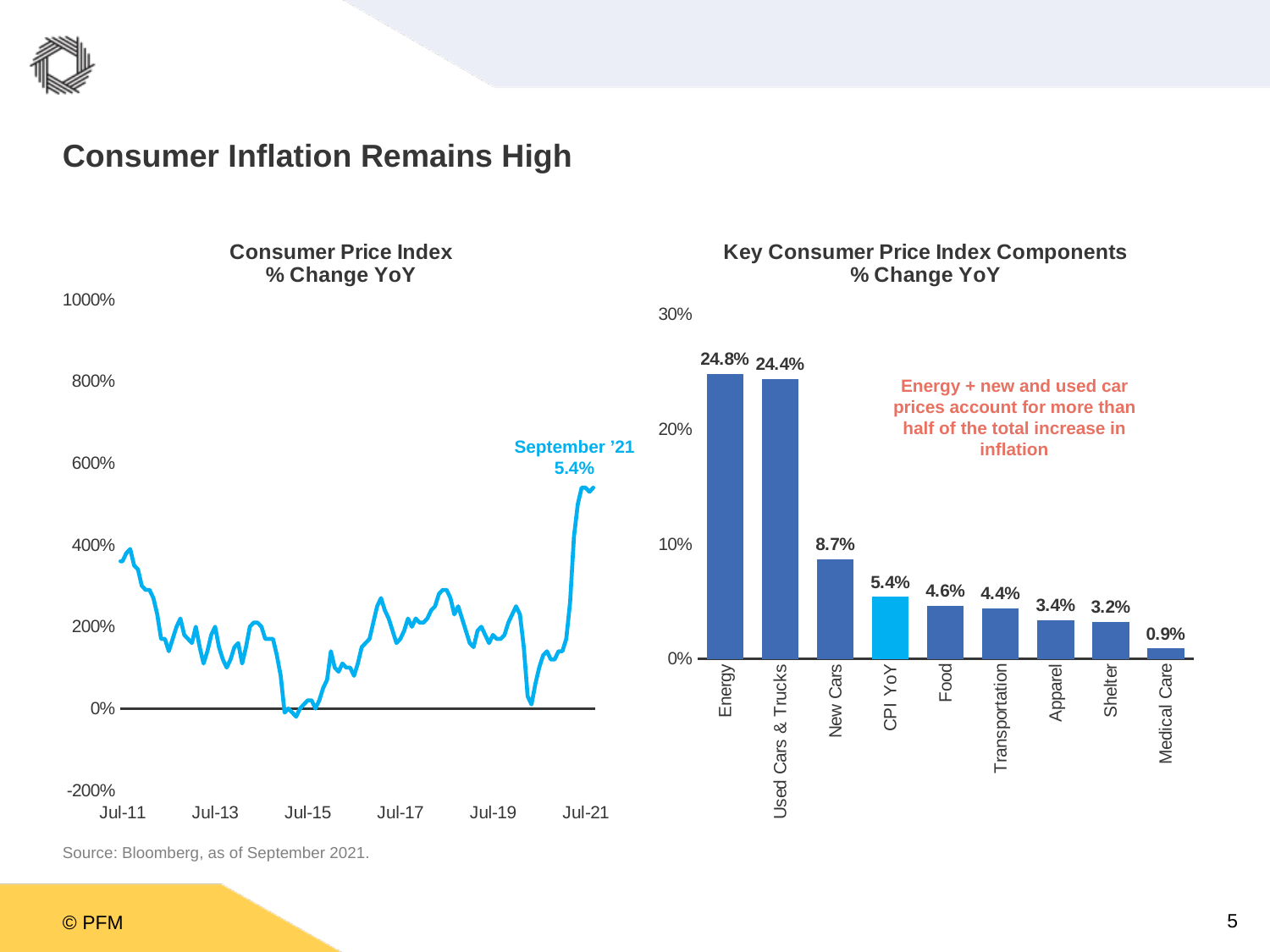
In the Consumer Price Index % Change YoY chart, what value is annotated for September '21? 5.4% In the Key Consumer Price Index Components chart, which component has the lowest value? Medical Care In the Key Consumer Price Index Components chart, which is larger, Food or Transportation? Food In the Key Consumer Price Index Components chart, how much higher is New Cars than CPI YoY? 3.3% In the Key Consumer Price Index Components chart, what is the % change YoY for Energy? 24.8% In the Key Consumer Price Index Components chart, what is the value for Medical Care? 0.9% What kind of chart is the Consumer Price Index % Change YoY chart on the left? Line chart In the Key Consumer Price Index Components chart, which component has the highest value? Energy What is the title of the chart on the left side of the slide? Consumer Price Index % Change YoY How many components are shown in the Key Consumer Price Index Components chart? 9 What kind of chart is the Key Consumer Price Index Components chart on the right? Bar chart In the Key Consumer Price Index Components chart, what is the difference between the Energy value and the Used Cars & Trucks value? 0.4%